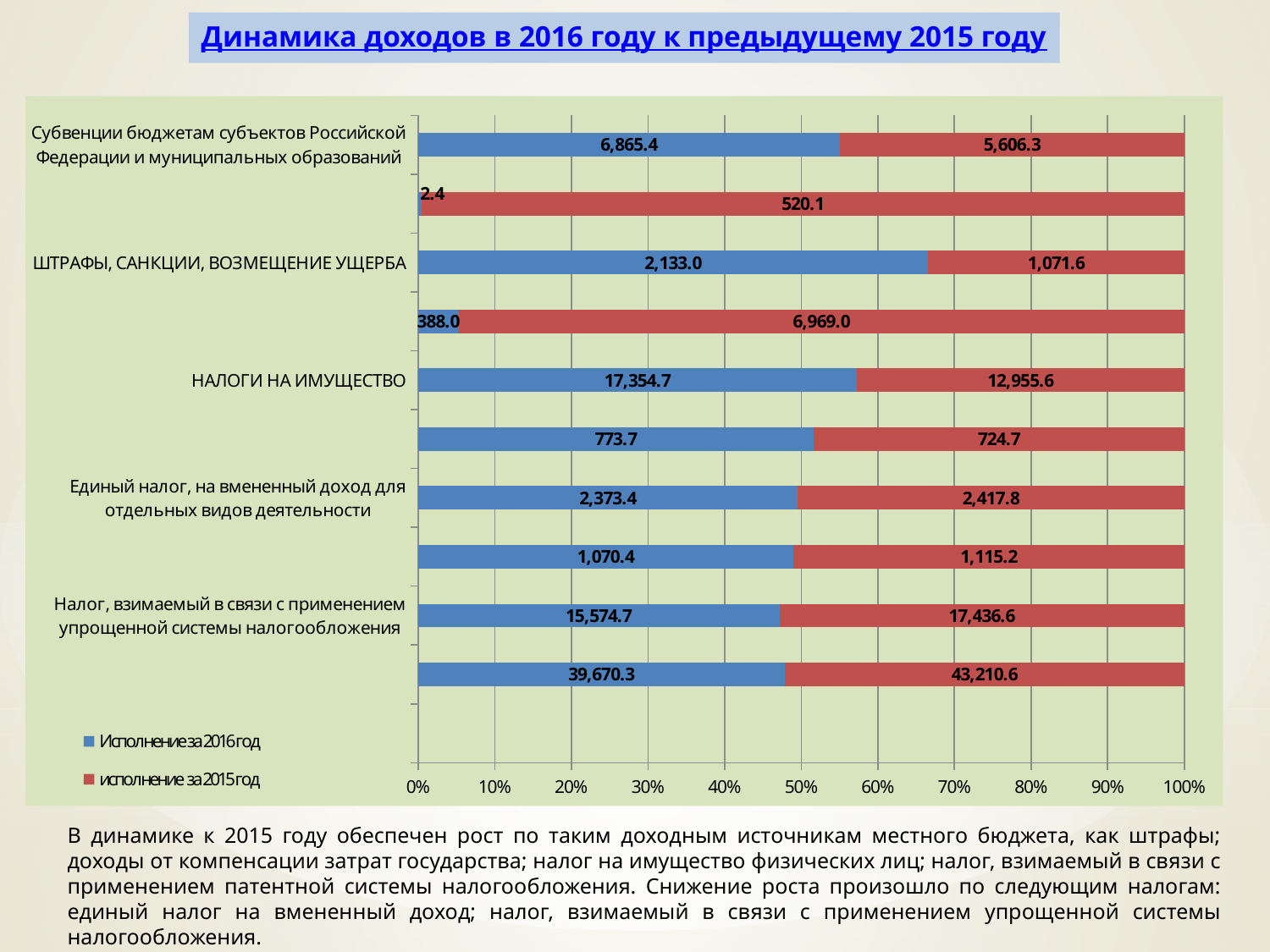
For 'Единый налог, на вмененный доход для отдельных видов деятельности', which is larger: the 2016 value or the 2015 value? the 2015 value (2,417.8) How many series does the legend list? 2 What is the value of 'исполнение за 2015 год' for 'ШТРАФЫ, САНКЦИИ, ВОЗМЕЩЕНИЕ УЩЕРБА'? 1,071.6 What is the 2016 value for 'Субвенции бюджетам субъектов Российской Федерации и муниципальных образований'? 6,865.4 How many bars are plotted in the chart? 10 What is the 2015 value for 'Налог, взимаемый в связи с применением упрощенной системы налогообложения'? 17,436.6 What is the title of the chart? Динамика доходов в 2016 году к предыдущему 2015 году What is the difference between the 2016 and 2015 values for 'НАЛОГИ НА ИМУЩЕСТВО'? 4,399.1 Is the share of the 2016 segment in the 'ШТРАФЫ, САНКЦИИ, ВОЗМЕЩЕНИЕ УЩЕРБА' bar greater or less than 60%? greater What type of chart is shown on the slide? bar chart What is the value of 'Исполнение за 2016 год' for 'НАЛОГИ НА ИМУЩЕСТВО'? 17,354.7 What is the difference between the 2015 and 2016 values for 'Налог, взимаемый в связи с применением упрощенной системы налогообложения'? 1,861.9